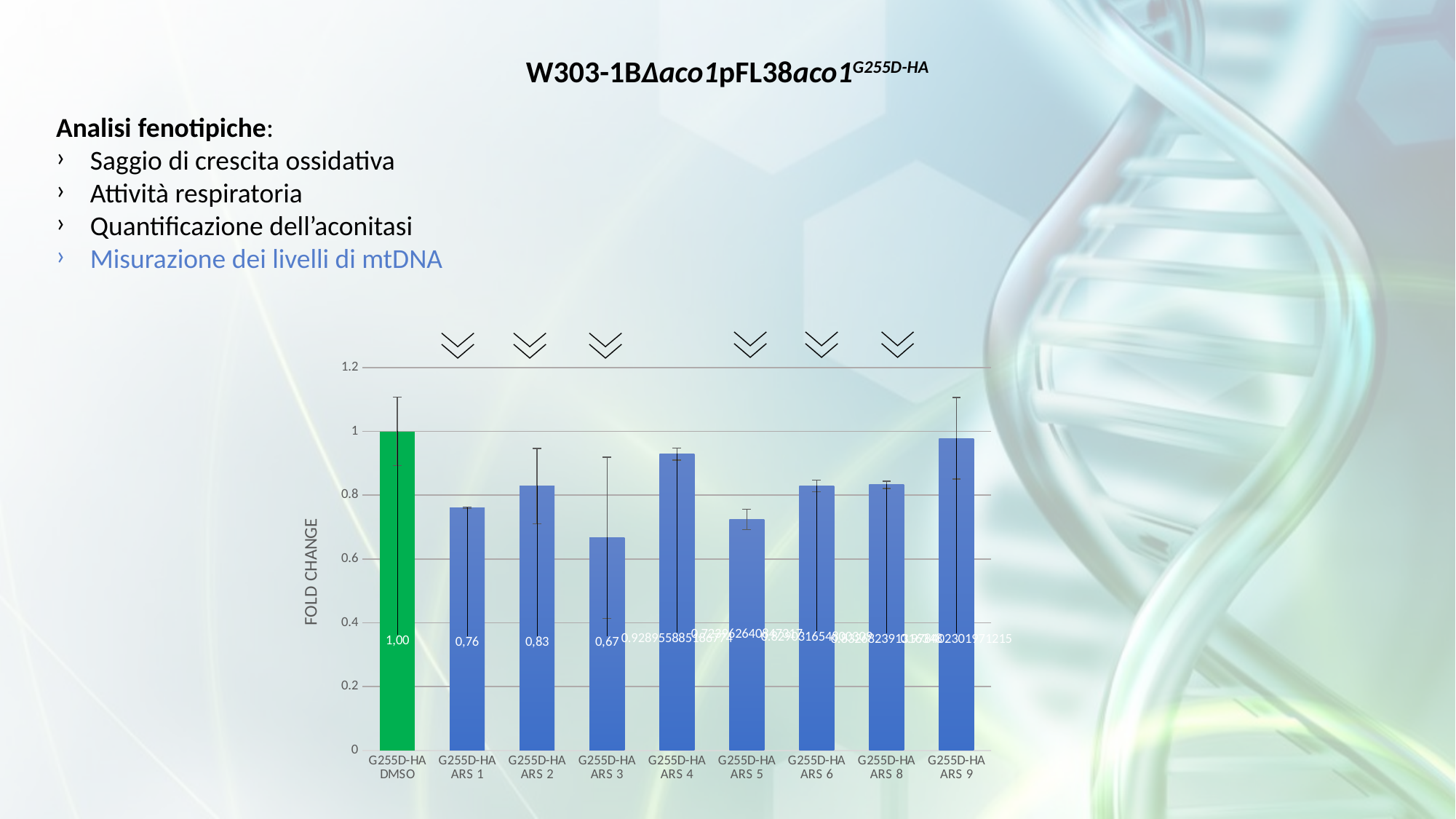
Which has a higher fold change, G255D-HA ARS 1 or G255D-HA ARS 2? G255D-HA ARS 2 Which category has the lowest fold change? G255D-HA ARS 3 What is the difference in fold change between G255D-HA DMSO and G255D-HA ARS 1? 0,24 What kind of chart is shown on the slide? bar chart What is the fold change value for G255D-HA ARS 1? 0,76 What is the difference in fold change between G255D-HA ARS 2 and G255D-HA ARS 3? 0,16 Is the fold change for G255D-HA ARS 5 greater or less than 0.8? less Is the fold change for G255D-HA ARS 4 greater or less than 0.8? greater What is the fold change value for G255D-HA ARS 2? 0,83 What is the fold change value for G255D-HA DMSO? 1,00 What is the fold change value for G255D-HA ARS 3? 0,67 How many categories are shown on the x axis of the chart? 9